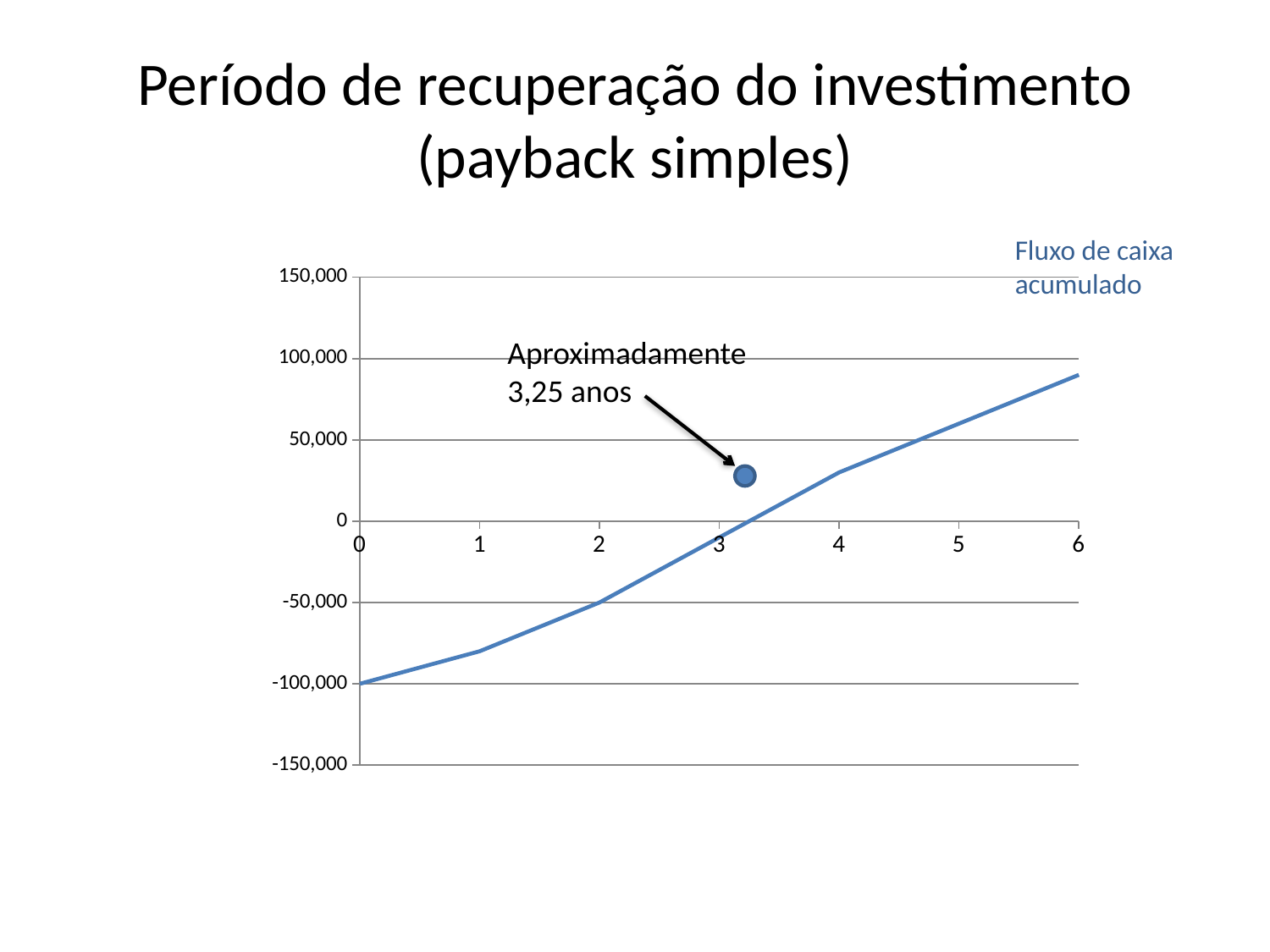
Is the value at year 3 greater or less than 0? less According to the annotation on the chart, approximately how many years is the payback period? 3,25 anos Is the value at year 4 greater or less than 50,000? less At which year is the cumulative cash flow lowest? 0 Is the value at year 1 greater or less than -50,000? less Does the cumulative cash flow rise or fall as the years increase? rise What is the cumulative cash flow value at year 0? -100,000 At which year is the cumulative cash flow highest? 6 What kind of chart is shown on the slide? line chart Which is larger, the value at year 2 or the value at year 4? year 4